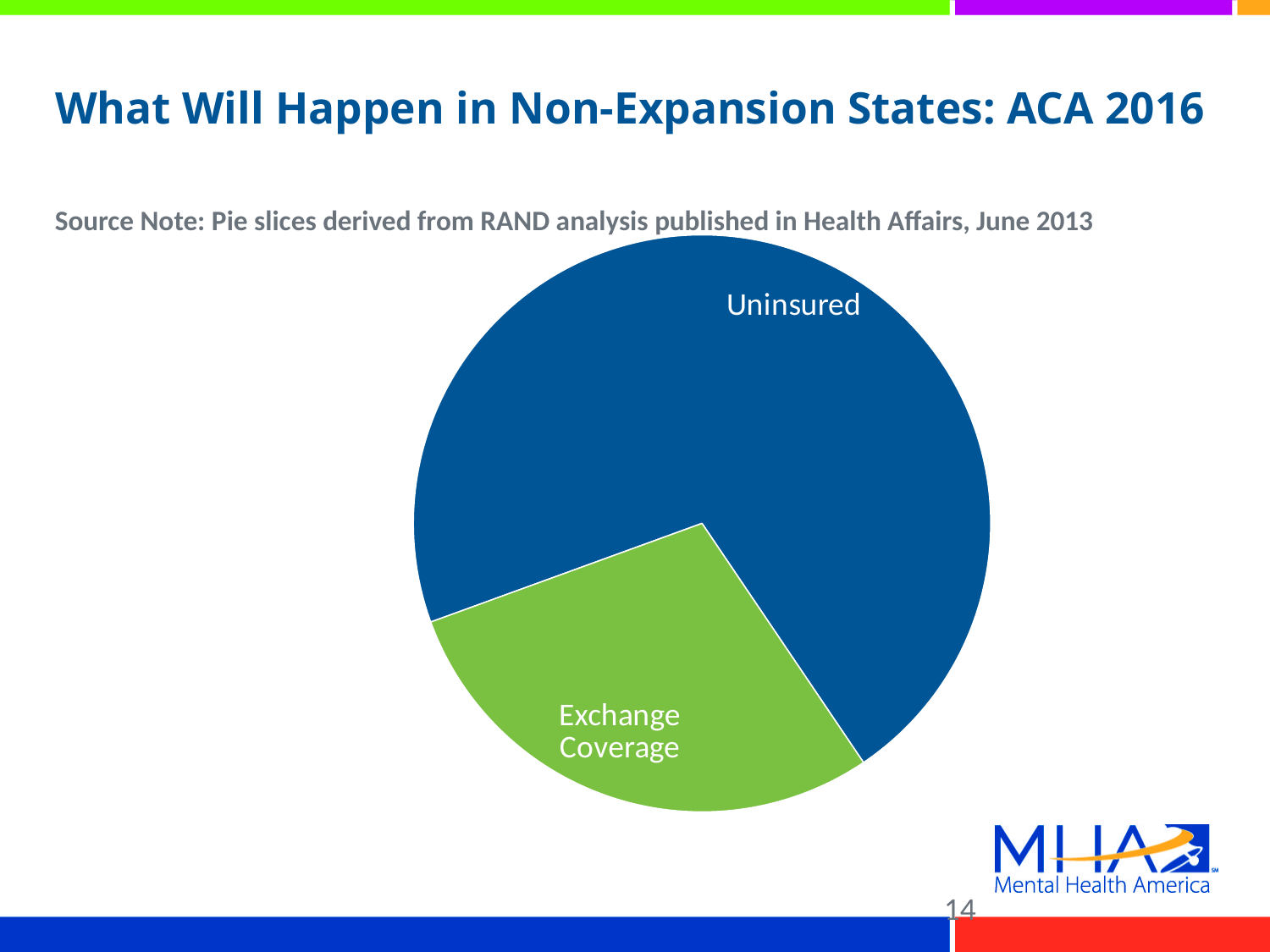
Does the Uninsured slice take up more or less than half of the pie? more What colour is the Exchange Coverage slice? green What colour is the Uninsured slice? blue Which slice of the pie chart is the smallest? Exchange Coverage How many slices does the pie chart have? 2 Which slice is larger, Uninsured or Exchange Coverage? Uninsured Does the Exchange Coverage slice take up more or less than half of the pie? less Which slice of the pie chart is the largest? Uninsured What kind of chart is shown on the slide? pie chart